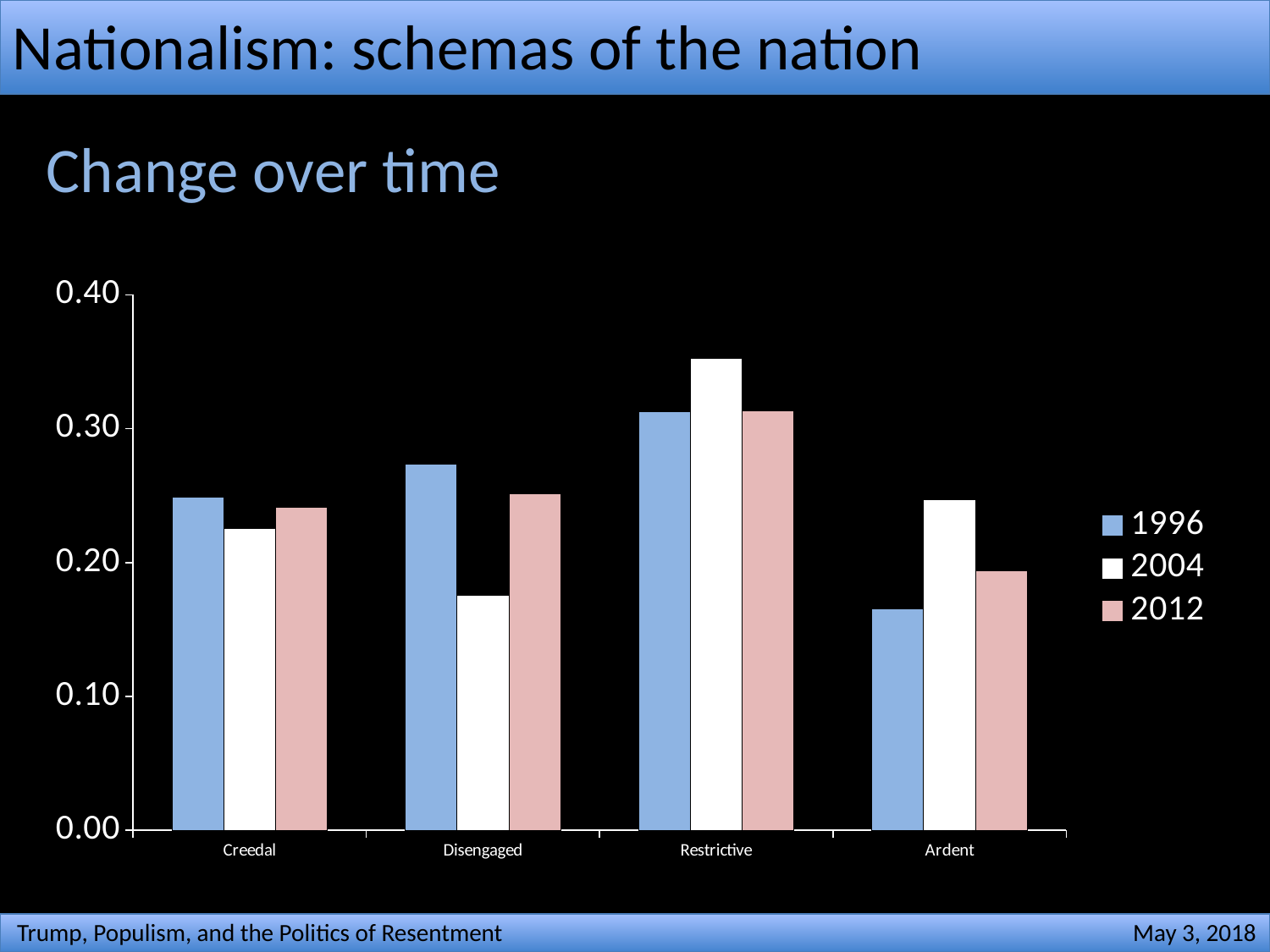
What kind of chart is shown on the slide? bar chart How many categories are shown on the x axis of the chart? 4 Is the value for Restrictive in 2004 greater or less than 0.30? greater How many series does the chart's legend list? 3 Which series is shown in white bars in the chart? 2004 Which category has the lowest value for the 1996 series? Ardent For the Ardent category, which is larger: the 2004 value or the 1996 value? 2004 Which category has the highest value for the 2004 series? Restrictive Is the value for Ardent in 1996 greater or less than 0.20? less Which category has the lowest value for the 2004 series? Disengaged Which category has the highest value for the 2012 series? Restrictive Is the value for Disengaged in 2004 greater or less than 0.20? less